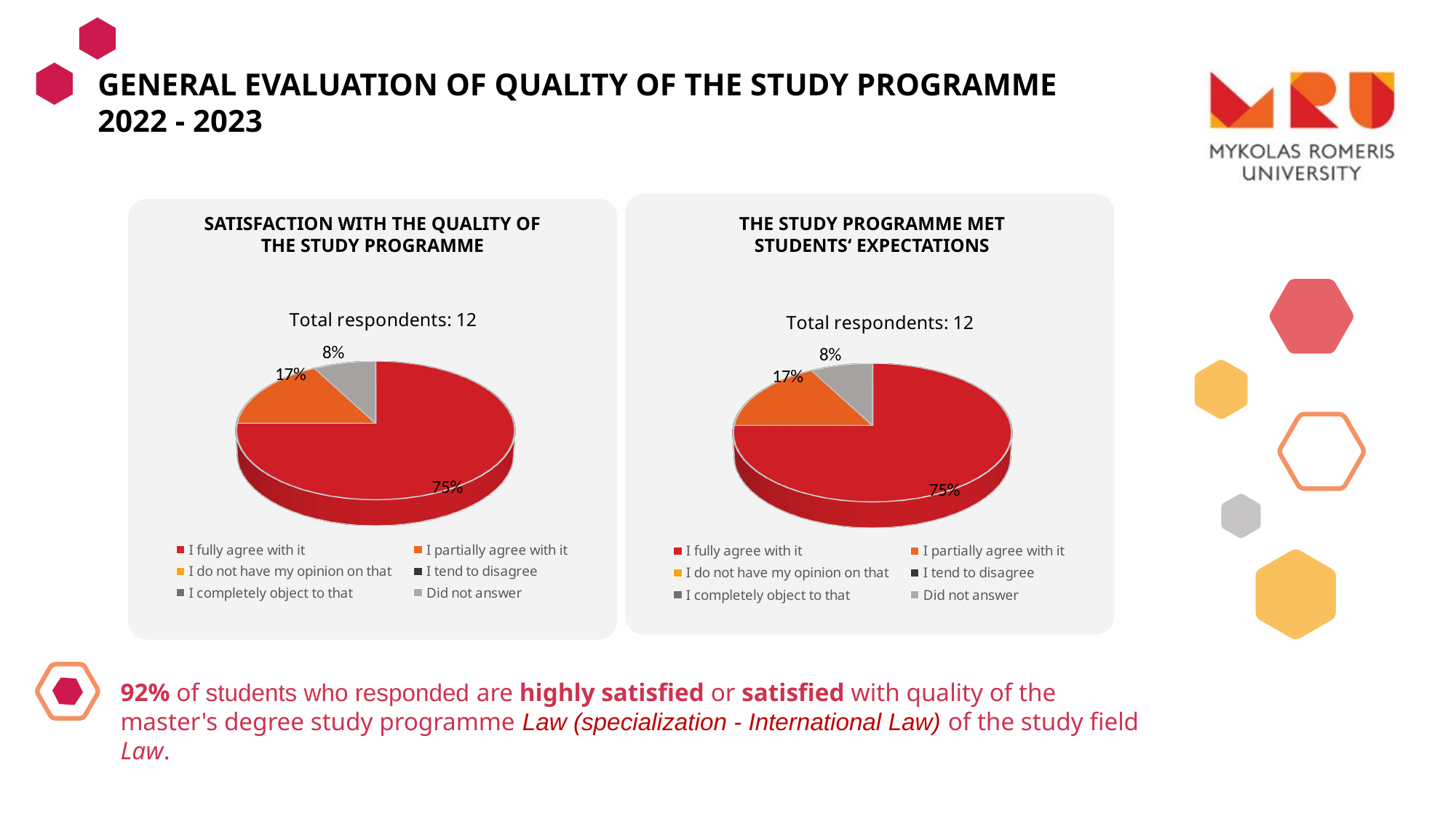
How many entries does the legend of the 'The study programme met students' expectations' chart list? 6 What type of chart is used in the 'Satisfaction with the quality of the study programme' panel? Pie chart In the 'The study programme met students' expectations' chart, which is larger: 'I partially agree with it' or 'Did not answer'? I partially agree with it How many total respondents are reported for the 'Satisfaction with the quality of the study programme' chart? 12 In the 'Satisfaction with the quality of the study programme' chart, which labelled slice is the smallest? Did not answer In the 'The study programme met students' expectations' chart, what share of respondents fully agree with it? 75% In the 'Satisfaction with the quality of the study programme' chart, what is the difference in percentage points between 'I fully agree with it' and 'I partially agree with it'? 58 In the 'Satisfaction with the quality of the study programme' chart, what share of respondents did not answer? 8% In the 'Satisfaction with the quality of the study programme' chart, what share of respondents fully agree with it? 75% In the 'The study programme met students' expectations' chart, what share of respondents partially agree with it? 17% In the 'Satisfaction with the quality of the study programme' chart, what share of respondents partially agree with it? 17% In the 'The study programme met students' expectations' chart, which response category has the largest slice? I fully agree with it